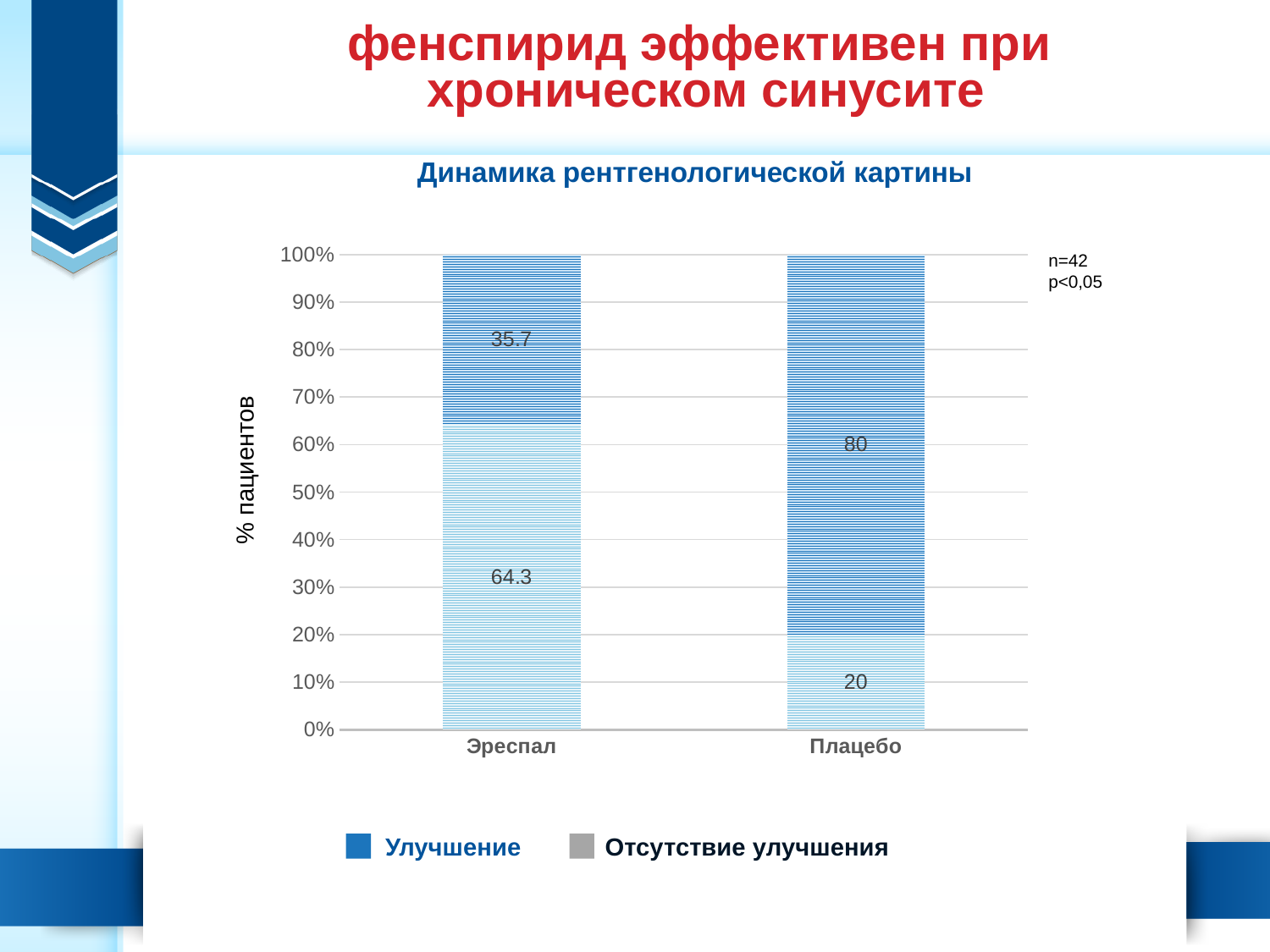
How many series does the legend list? 2 What is the value of the bottom segment of the Эреспал bar? 64.3 What is the value of the bottom segment of the Плацебо bar? 20 What is the total of the two segments in the Эреспал bar? 100 What is the value of the top segment of the Эреспал bar? 35.7 Which bar has the larger bottom segment, Эреспал or Плацебо? Эреспал What is the title of the chart? Динамика рентгенологической картины What is the label of the vertical axis? % пациентов What is the difference between the bottom segment values of the Эреспал and Плацебо bars? 44.3 How many categories are shown on the x axis of the chart? 2 What is the value of the top segment of the Плацебо bar? 80 What kind of chart is shown on the slide? Stacked bar chart